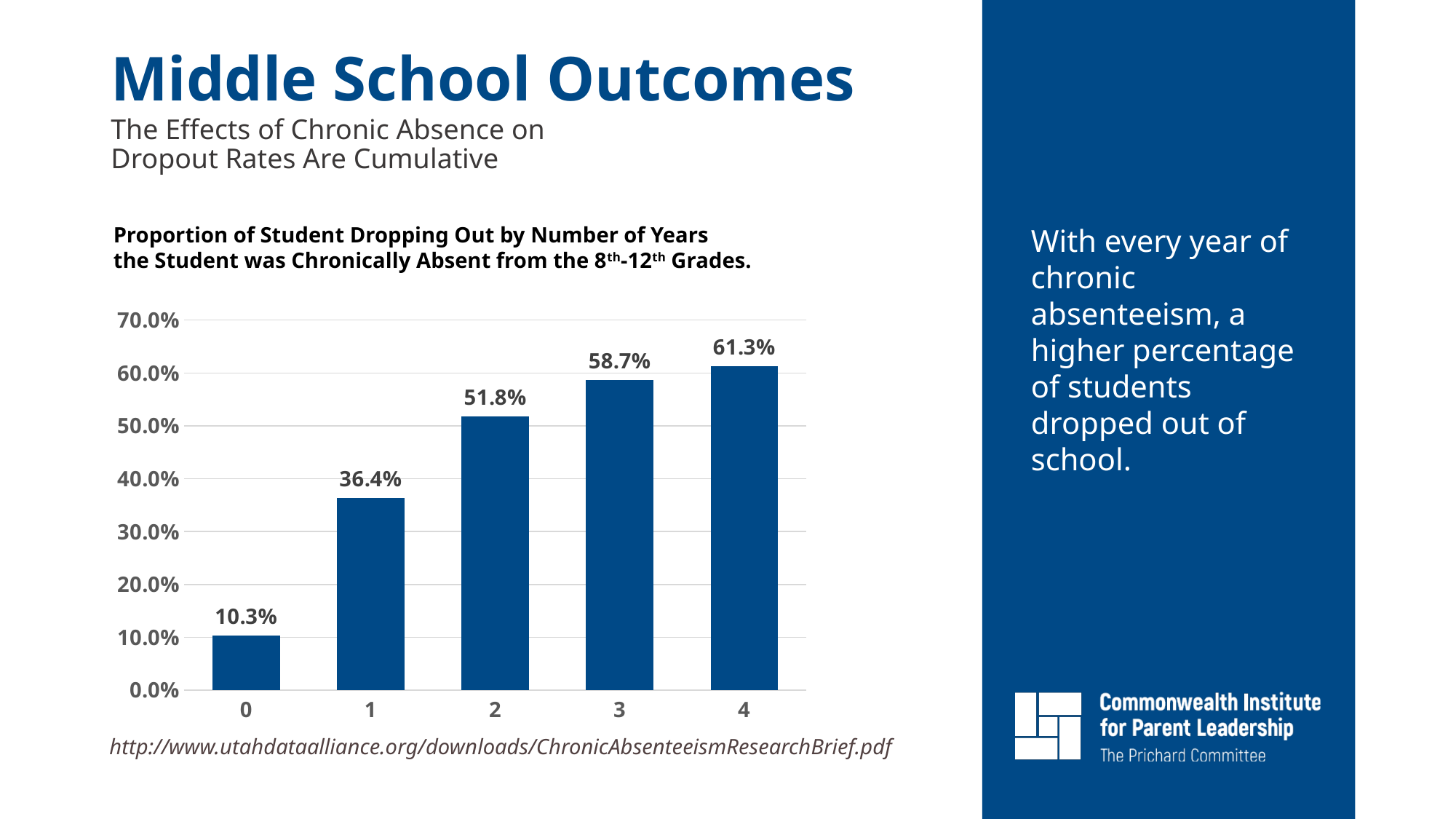
Is the dropout proportion for 2 years of chronic absence greater or less than 50.0%? greater What is the difference in dropout proportion between 4 years and 3 years of chronic absence? 2.6% What proportion of students dropped out when they were chronically absent for 0 years? 10.3% How many bars are shown in the chart? 5 What is the dropout proportion for students chronically absent for 2 years? 51.8% What type of chart is shown on the slide? Bar chart Which number of years of chronic absence has the lowest dropout proportion? 0 Which number of years of chronic absence has the highest dropout proportion? 4 Do the dropout proportions rise or fall as the number of years of chronic absence increases? Rise What is the difference in dropout proportion between 1 year and 0 years of chronic absence? 26.1% Which has a higher dropout proportion: 1 year or 3 years of chronic absence? 3 years What is the dropout proportion for students chronically absent for 4 years? 61.3%